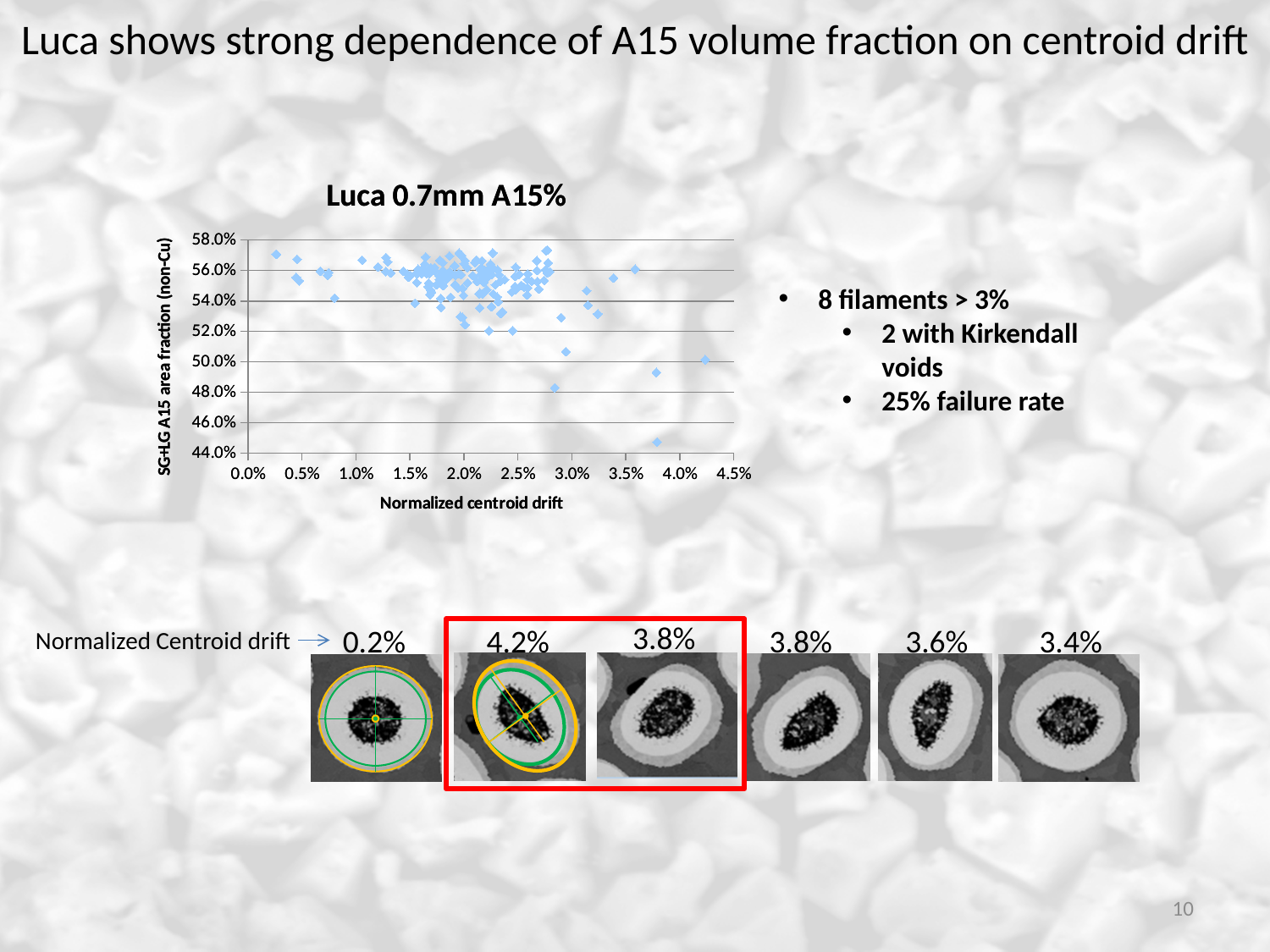
Are most of the plotted points above or below 54.0% A15 area fraction? above As normalized centroid drift increases along the x axis, do the A15 area fraction values generally rise or fall? fall Is the normalized centroid drift of the lowest plotted point greater or less than 3.5%? greater Is the lowest plotted A15 area fraction value greater or less than 46.0%? less What is the label of the x axis of the chart? Normalized centroid drift Which has the higher A15 area fraction: the point with the smallest centroid drift or the point with the largest centroid drift? the point with the smallest centroid drift What kind of chart is shown on the slide? scatter chart What is the title of the chart? Luca 0.7mm A15%